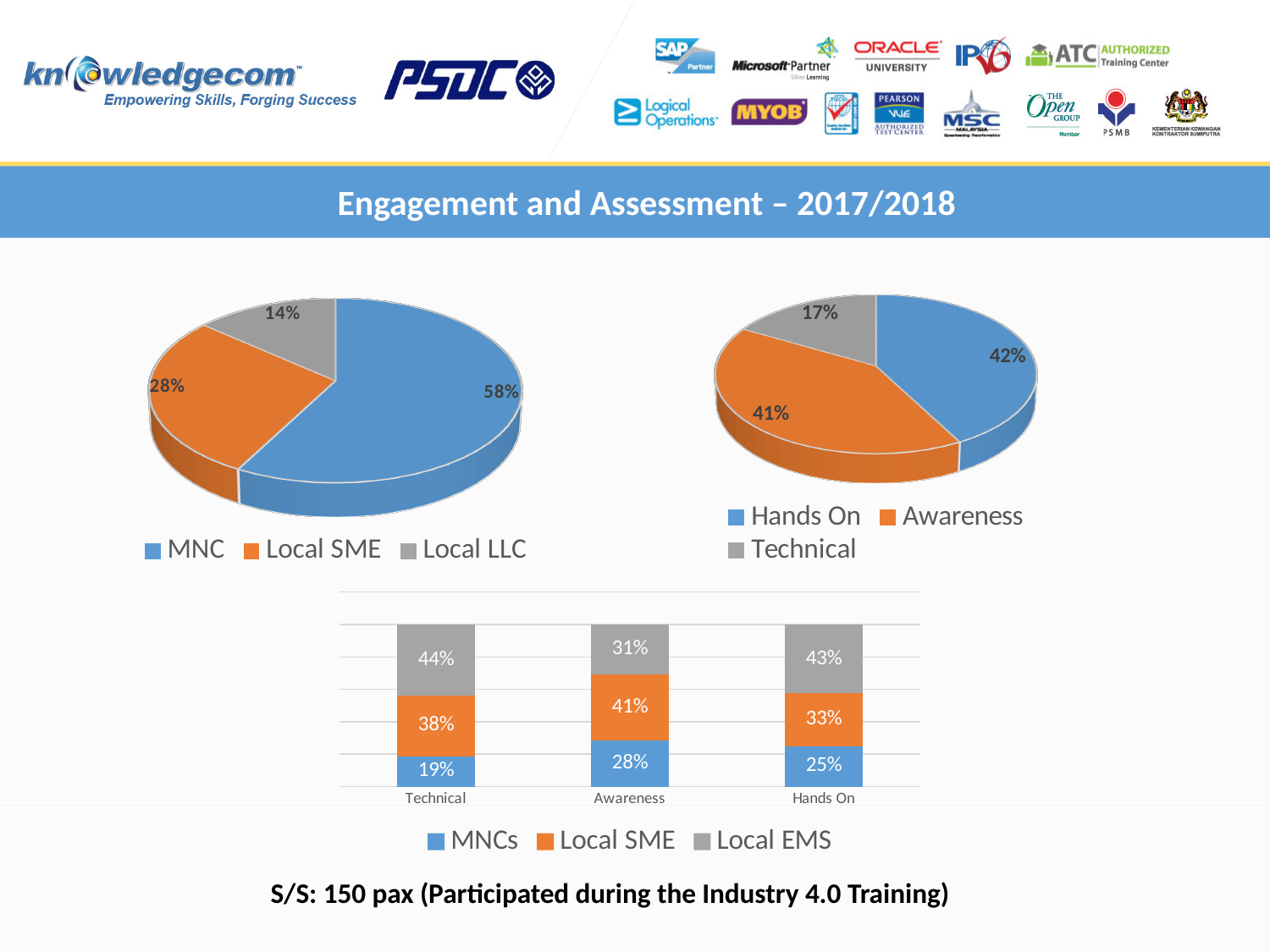
What type of chart is shown at the bottom of the slide? Stacked bar chart In the pie chart on the left, what share does MNC have? 58% In the pie chart on the right, which category has the largest slice? Hands On In the stacked bar chart at the bottom, what is the MNCs value for Technical? 19% In the stacked bar chart at the bottom, what is the difference between the Local EMS values for Technical and Awareness? 13% In the stacked bar chart at the bottom, which category has the highest MNCs value? Awareness In the pie chart on the right, what share does Technical have? 17% In the stacked bar chart at the bottom, what is the Local SME value for Awareness? 41% In the stacked bar chart at the bottom, how many series does the legend list? 3 In the stacked bar chart at the bottom, which is larger: the Local SME value for Technical or for Hands On? Technical In the pie chart on the right, how many categories does the legend list? 3 In the pie chart on the left, which category has the smallest slice? Local LLC